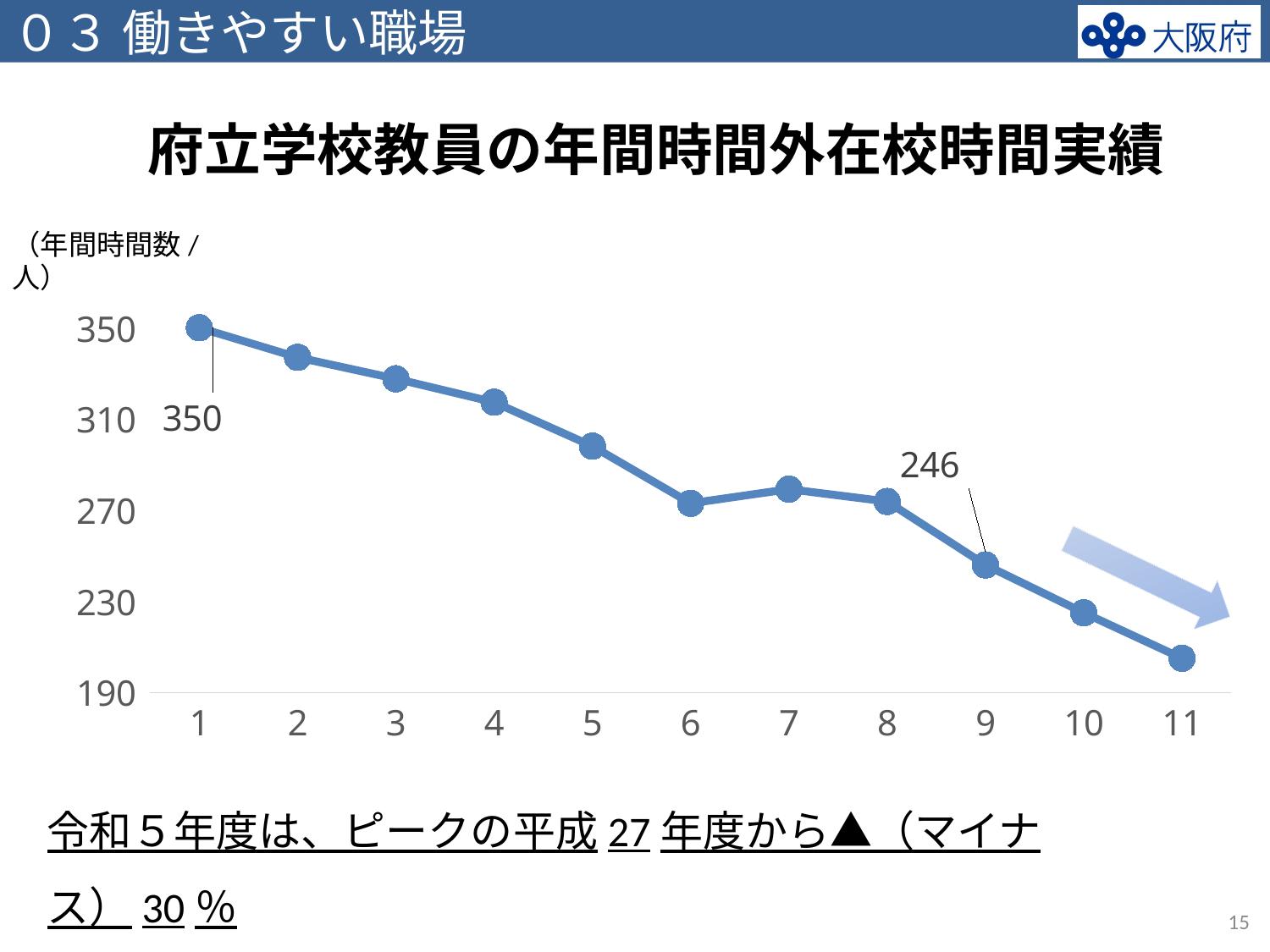
Is the value for category 5 greater or less than 270? greater What kind of chart is shown on the slide? Line chart What is the value plotted for category 9? 246 Which category has the highest value? 1 Do the values generally rise or fall from category 1 to category 11? Fall What is the value plotted for category 1? 350 How many data points are plotted on the line? 11 Which category has the lowest value? 11 What is the title of the chart? 府立学校教員の年間時間外在校時間実績 Is the value for category 11 greater or less than 230? less Which is larger, the value for category 3 or the value for category 5? Category 3 What is the difference between the values for category 1 and category 9? 104